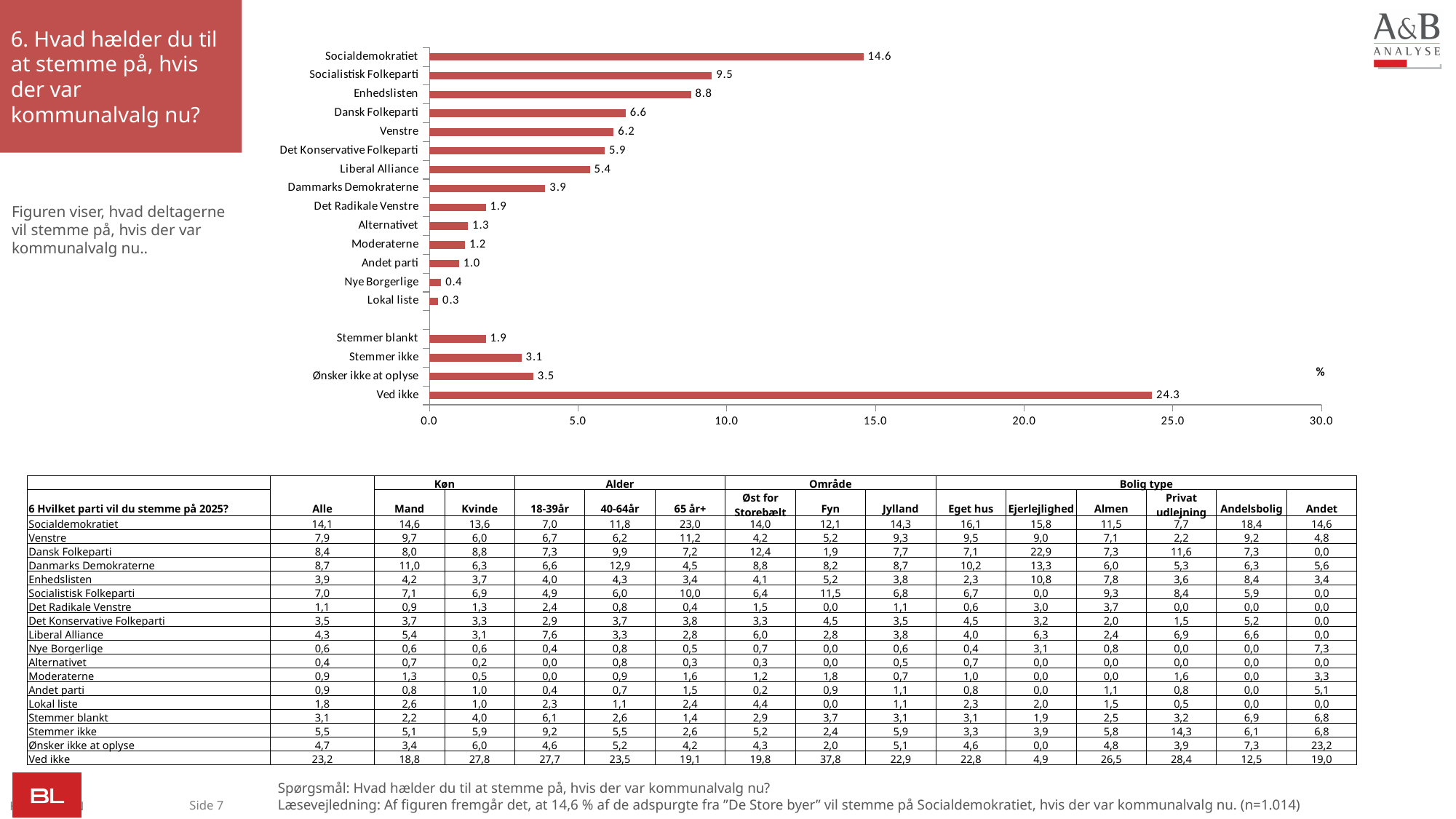
What is the value for Socialdemokratiet in the bar chart? 14.6 What is the value for Nye Borgerlige in the bar chart? 0.4 How many bars are plotted in the chart? 18 What is the difference between the values for Socialdemokratiet and Socialistisk Folkeparti? 5.1 Which has a larger value, Dansk Folkeparti or Venstre? Dansk Folkeparti Which category has the highest value in the bar chart? Ved ikke What kind of chart is shown on the slide? bar chart What is the value for Liberal Alliance in the bar chart? 5.4 What is the value for Ved ikke in the bar chart? 24.3 Is the value for Ved ikke greater or less than 20.0? greater Which category has the lowest value in the bar chart? Lokal liste What is the maximum value shown on the x axis of the chart? 30.0